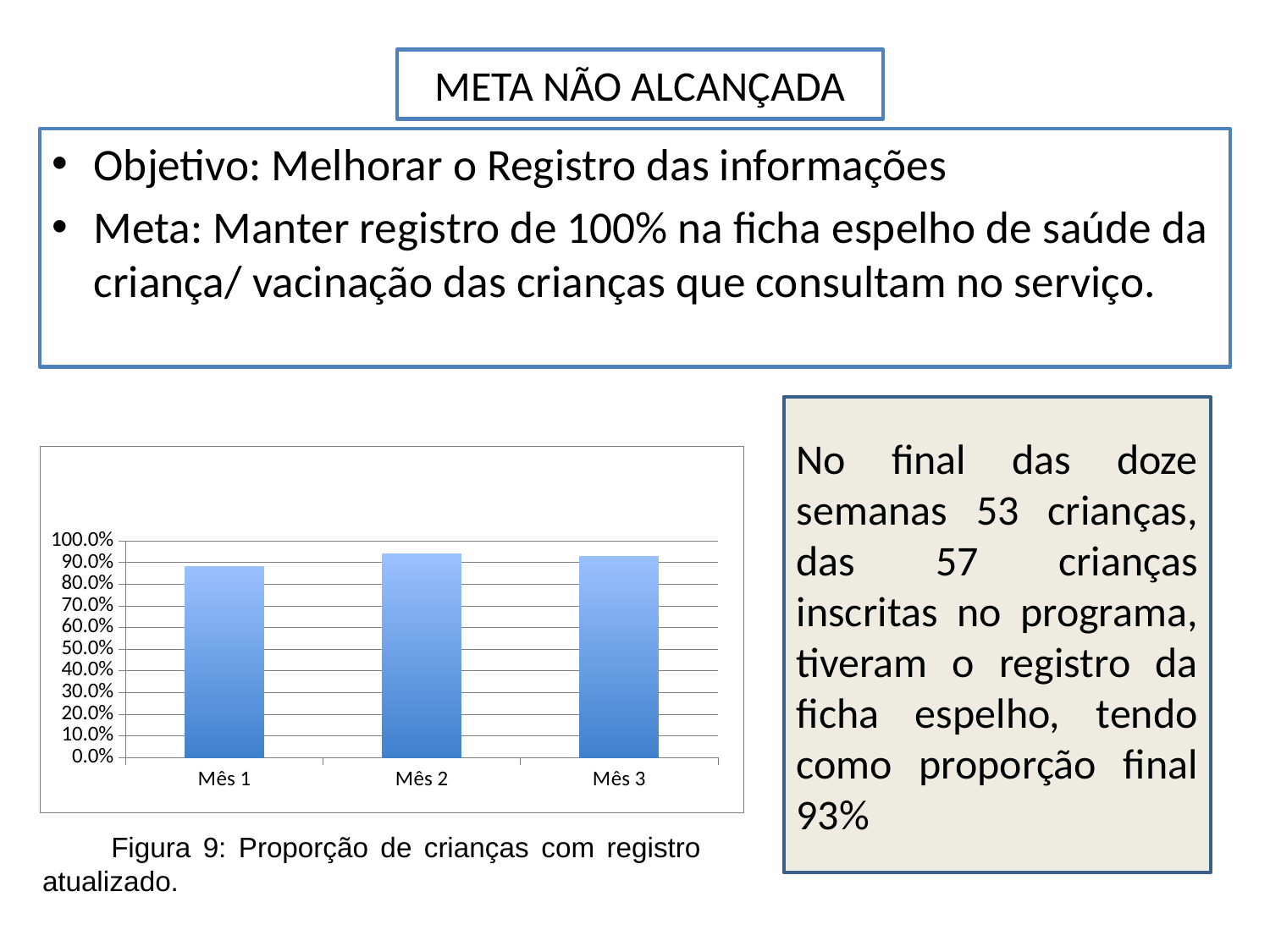
Is the value for Mês 2 greater or less than 90.0%? greater Is the value for Mês 1 greater or less than 80.0%? greater Which month has the lowest bar on the chart? Mês 1 How many months (categories) are plotted on the chart? 3 Which is larger, the value for Mês 1 or the value for Mês 2? Mês 2 What kind of chart is shown on the slide? bar chart What is the figure caption given below the chart? Figura 9: Proporção de crianças com registro atualizado. Is the value for Mês 3 greater or less than 100.0%? less What is the highest tick value shown on the vertical axis of the chart? 100.0% Which is larger, the value for Mês 1 or the value for Mês 3? Mês 3